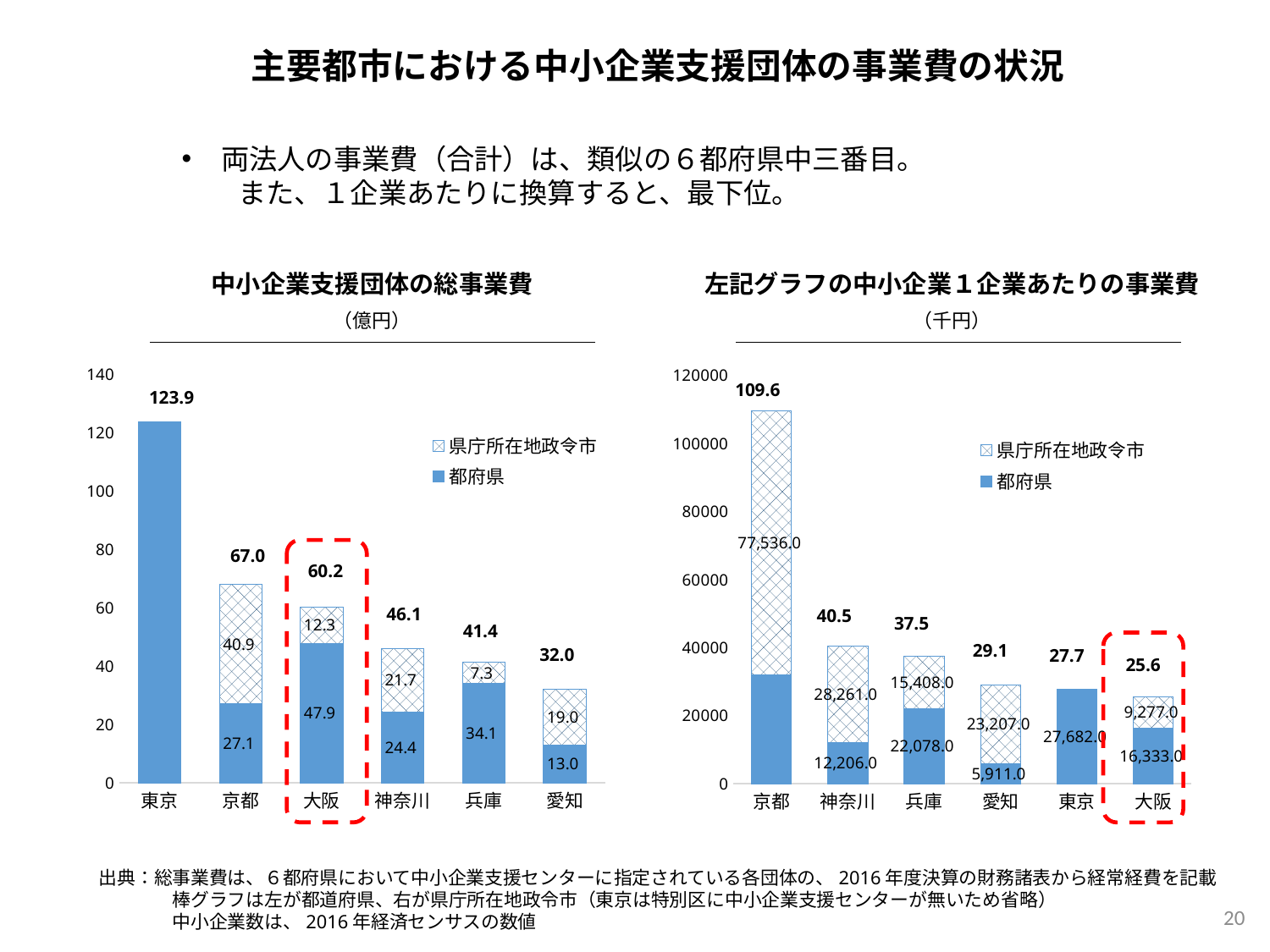
In the left chart (中小企業支援団体の総事業費), how many categories are shown on the x axis? 6 In the right chart (左記グラフの中小企業1企業あたりの事業費), what is the 県庁所在地政令市 value for 京都? 77,536.0 In the right chart (左記グラフの中小企業1企業あたりの事業費), what is the 都府県 value for 愛知? 5,911.0 In the right chart (左記グラフの中小企業1企業あたりの事業費), which category has the highest bar? 京都 What type of chart is used on this slide? Stacked bar chart In the left chart (中小企業支援団体の総事業費), what is the total value labelled for 東京? 123.9 In the right chart (左記グラフの中小企業1企業あたりの事業費), is the 都府県 value for 東京 larger or smaller than the 都府県 value for 大阪? larger In the left chart (中小企業支援団体の総事業費), what is the difference between the totals for 京都 and 大阪? 6.8 In the left chart (中小企業支援団体の総事業費), which category has the lowest total? 愛知 In the right chart (左記グラフの中小企業1企業あたりの事業費), is the bar for 神奈川 greater or less than 60000? less In the left chart (中小企業支援団体の総事業費), what is the 県庁所在地政令市 value for 京都? 40.9 In the left chart (中小企業支援団体の総事業費), what is the 都府県 value for 大阪? 47.9